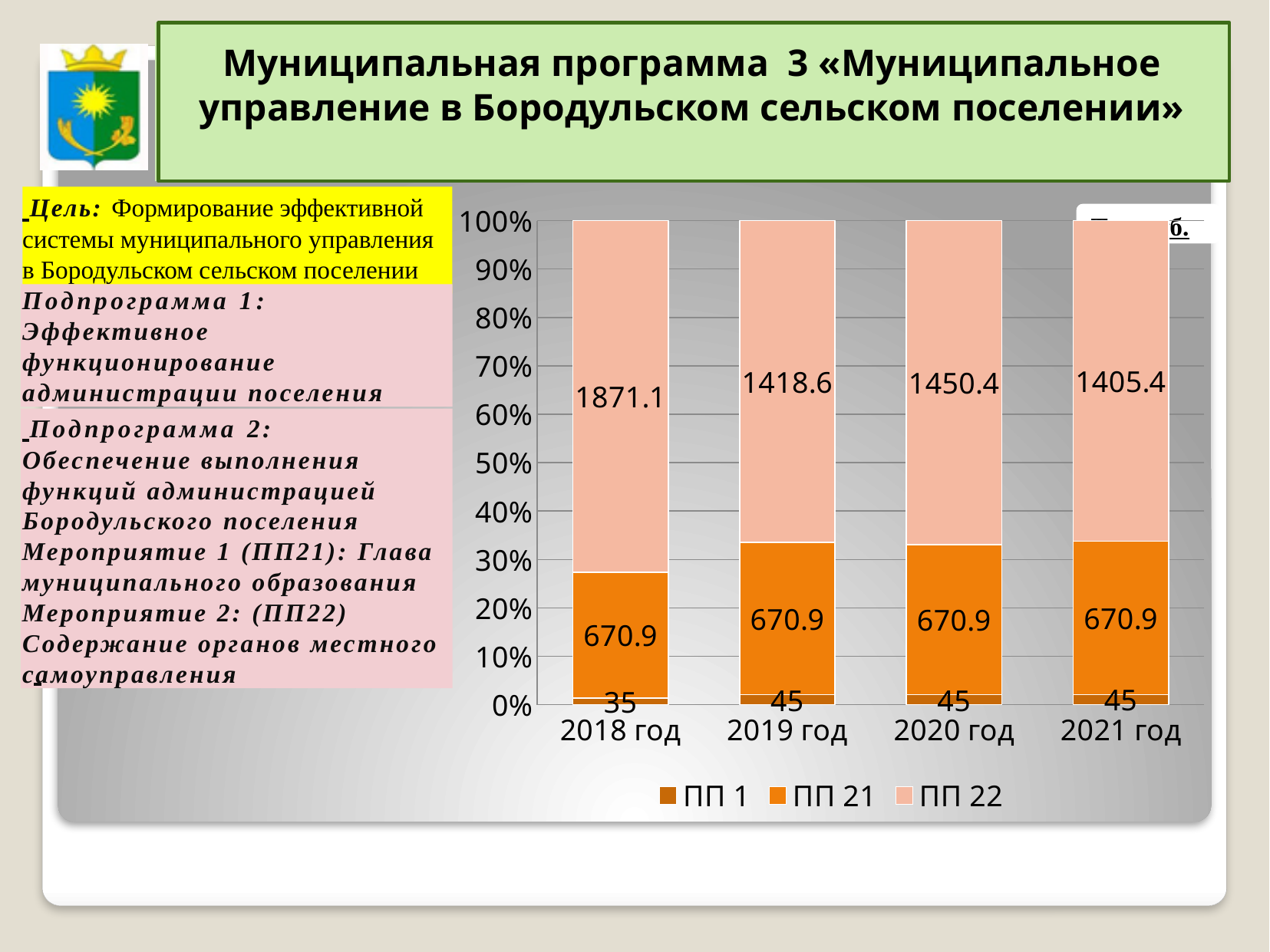
Which legend entry is shown in the lightest (pale pink) colour? ПП 22 How many year categories are shown on the x axis of the chart? 4 What is the value of ПП 1 for 2018 год? 35 What is the value of ПП 21 for 2021 год? 670.9 What is the value of ПП 22 for 2018 год? 1871.1 How many series does the chart legend list? 3 In which year is the value of ПП 22 the highest? 2018 год What type of chart is shown on the slide? stacked bar chart Which is larger, the ПП 22 value for 2020 год or for 2021 год? 2020 год In which year is the value of ПП 22 the lowest? 2021 год What is the total of the three segments in the bar for 2019 год? 2134.5 What is the difference between the ПП 22 values for 2018 год and 2019 год? 452.5